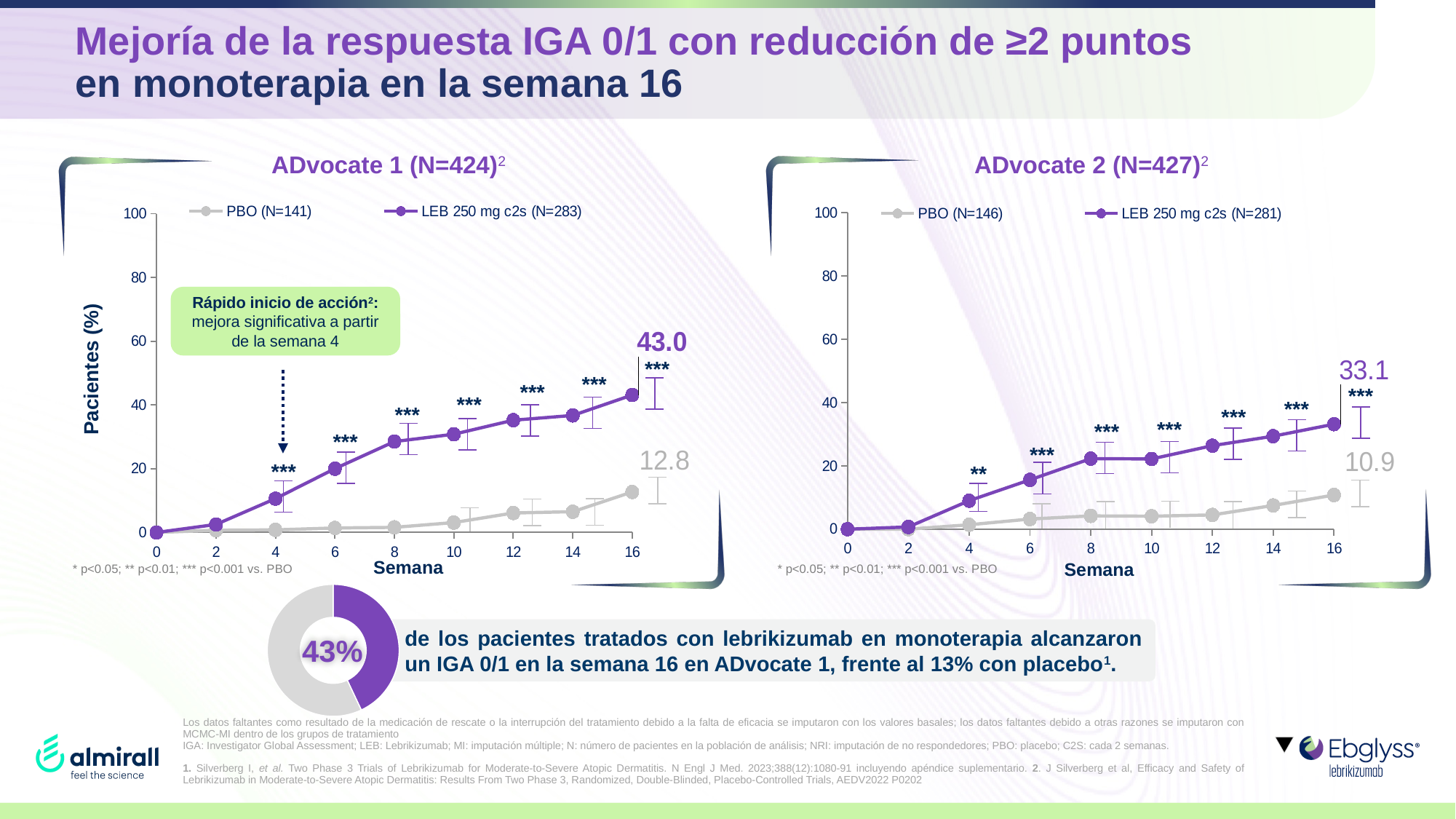
In the ADvocate 2 chart, what is the difference between the LEB 250 mg c2s and PBO values at week 16? 22.2 In the ADvocate 2 chart, what is the value for LEB 250 mg c2s at week 16? 33.1 What kind of chart is the ADvocate 2 chart? Line chart In the ADvocate 2 chart, what is the value for PBO at week 16? 10.9 Which chart shows the higher LEB 250 mg c2s value at week 16, ADvocate 1 or ADvocate 2? ADvocate 1 What share does the purple slice of the donut chart at the bottom of the slide represent? 43% In the ADvocate 1 chart, what is the value for LEB 250 mg c2s at week 16? 43.0 In the ADvocate 1 chart, is the value for LEB 250 mg c2s at week 8 greater or less than 20? greater How many series does the legend of the ADvocate 1 chart list? 2 In the ADvocate 2 chart, is the value for LEB 250 mg c2s at week 4 greater or less than 20? less In the ADvocate 1 chart, what is the difference between the LEB 250 mg c2s and PBO values at week 16? 30.2 In the ADvocate 1 chart, what is the value for PBO at week 16? 12.8